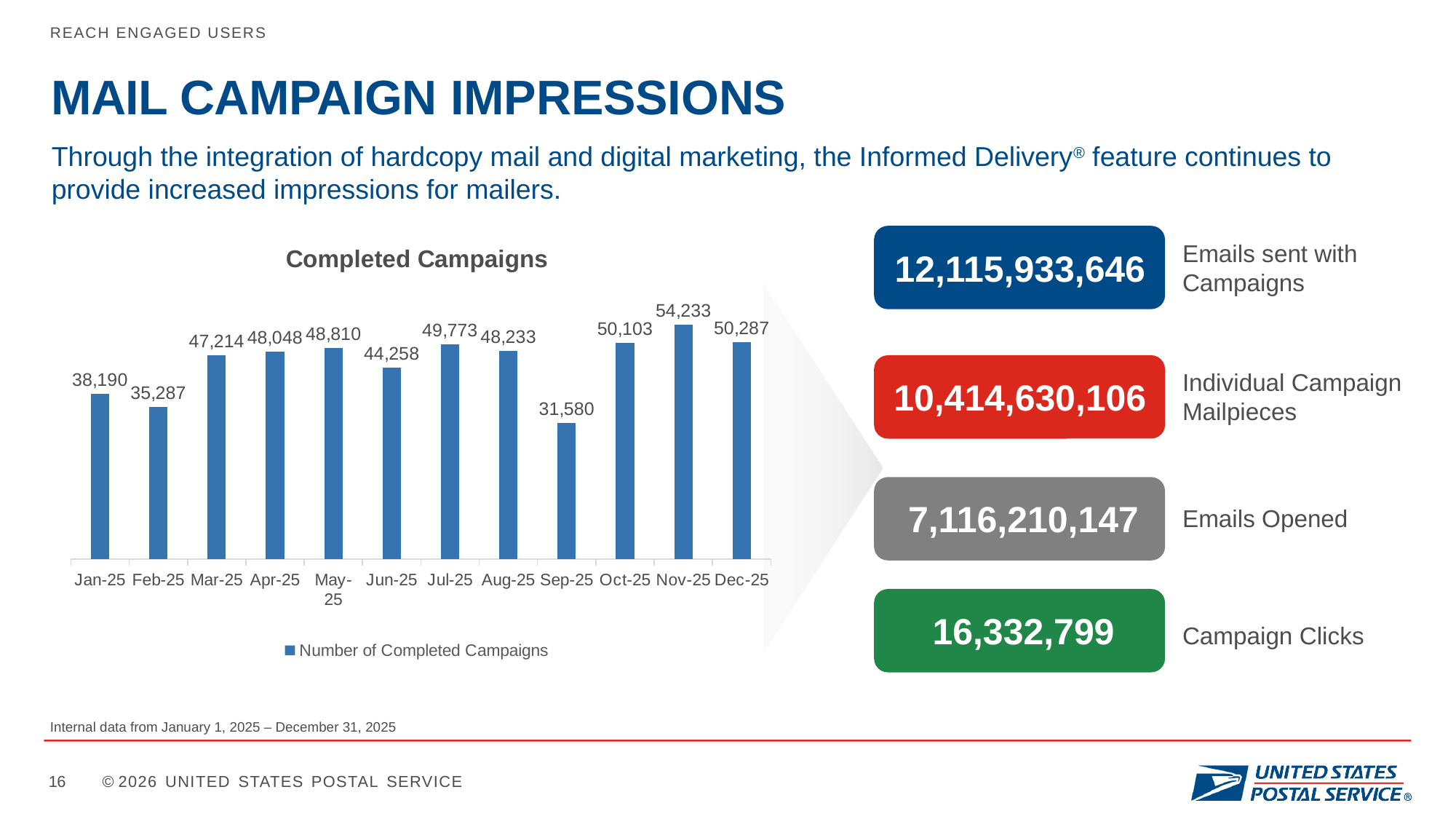
How many months are shown on the Completed Campaigns chart? 12 What is the number of completed campaigns for Jan-25? 38,190 What is the difference between the number of completed campaigns in Dec-25 and Jan-25? 12,097 What is the difference between the number of completed campaigns in Nov-25 and Sep-25? 22,653 What is the number of completed campaigns for Jul-25? 49,773 What type of chart is the Completed Campaigns chart? Bar chart Which month has the highest number of completed campaigns? Nov-25 What is the number of completed campaigns for Sep-25? 31,580 Which month has the lowest number of completed campaigns? Sep-25 What is the legend entry on the Completed Campaigns chart? Number of Completed Campaigns Which month has more completed campaigns, Mar-25 or Jun-25? Mar-25 How many series does the legend of the Completed Campaigns chart list? 1